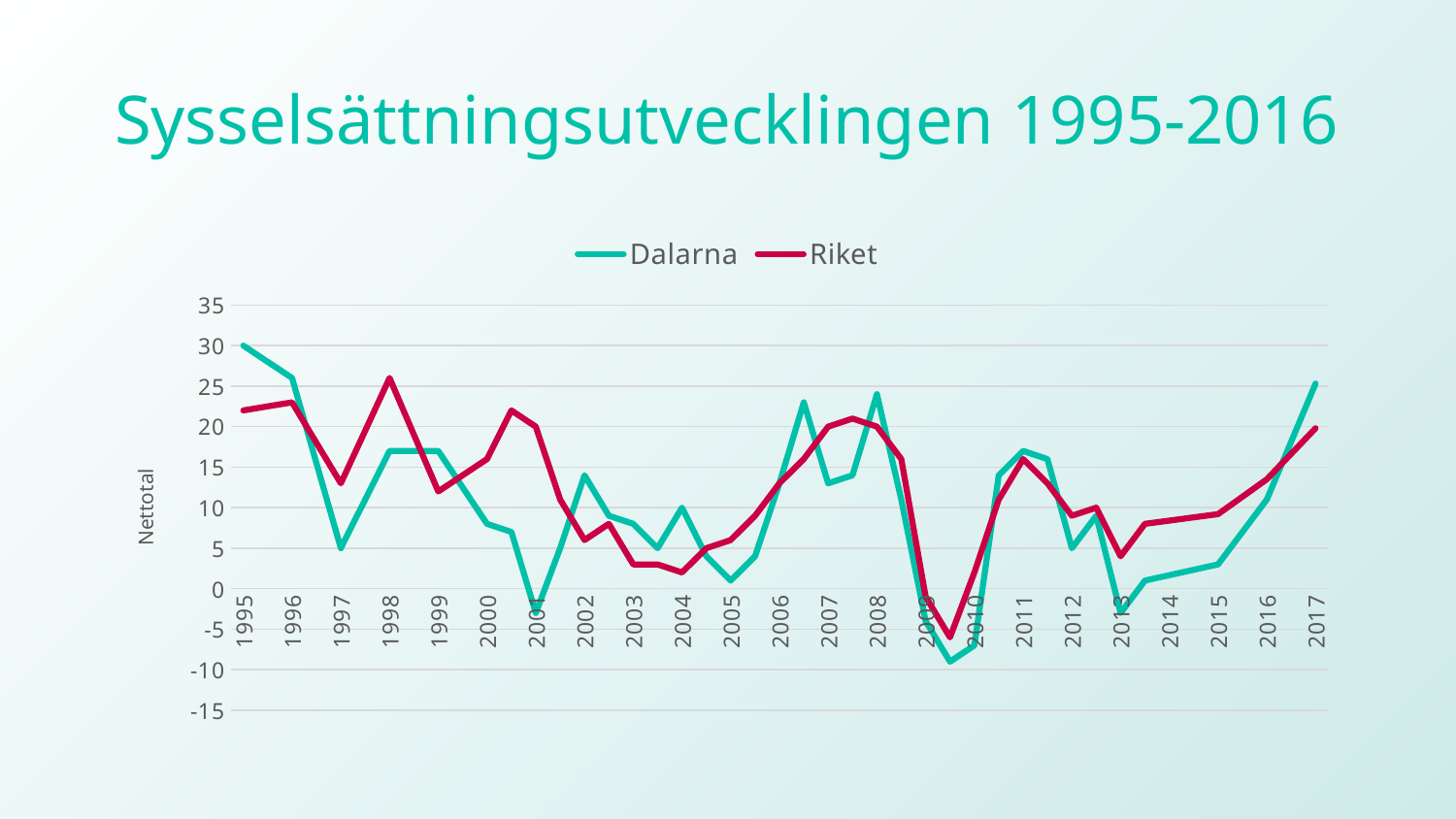
In which year does the Dalarna series reach its highest value? 1995 Which series has the higher value in 1998, Dalarna or Riket? Riket Is the value for Dalarna in 2009 greater or less than 0? less How many series does the legend list? 2 What kind of chart is shown on the slide? Line chart Is the value for Riket in 1998 greater or less than 20? greater What is the title of the chart? Sysselsättningsutvecklingen 1995-2016 In which year does the Riket series reach its highest value? 1998 How many years are plotted along the x axis? 23 Which series has the higher value in 1995, Dalarna or Riket? Dalarna In which year does the Dalarna series reach its lowest value? 2009 What is the label on the vertical axis? Nettotal